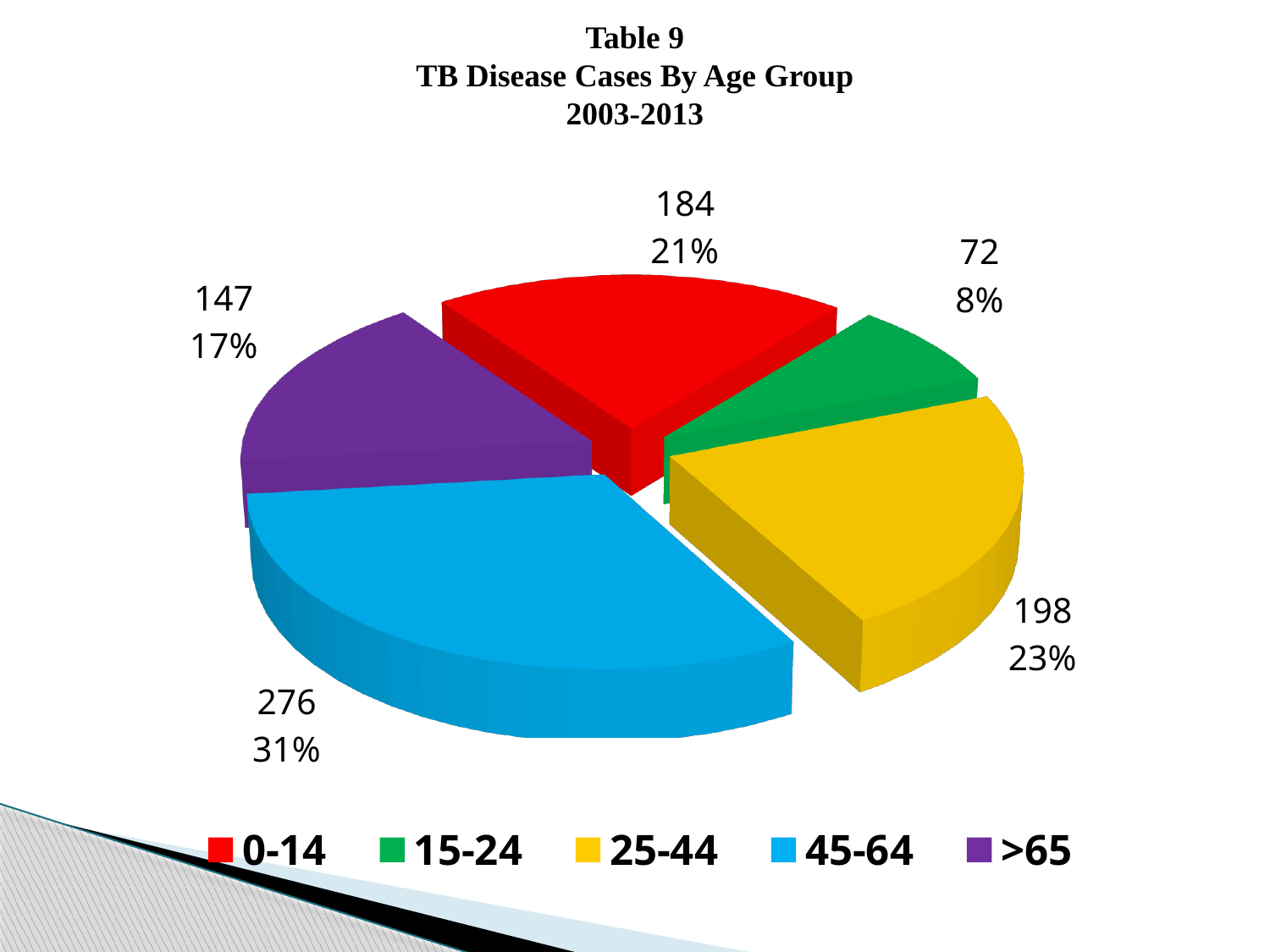
How many TB disease cases are shown for the 45-64 age group? 276 What percentage of TB disease cases does the 0-14 age group account for? 21% What is the difference in TB disease cases between the 45-64 and 25-44 age groups? 78 Which age group has the lowest number of TB disease cases? 15-24 How many TB disease cases are shown for the 15-24 age group? 72 What percentage of TB disease cases does the 25-44 age group account for? 23% Which age group has the highest number of TB disease cases? 45-64 What kind of chart is shown on the slide? Pie chart How many age groups are shown in the pie chart? 5 How many TB disease cases are shown for the >65 age group? 147 Which age group has more TB disease cases, 0-14 or >65? 0-14 What colour represents the 25-44 age group in the pie chart? Yellow